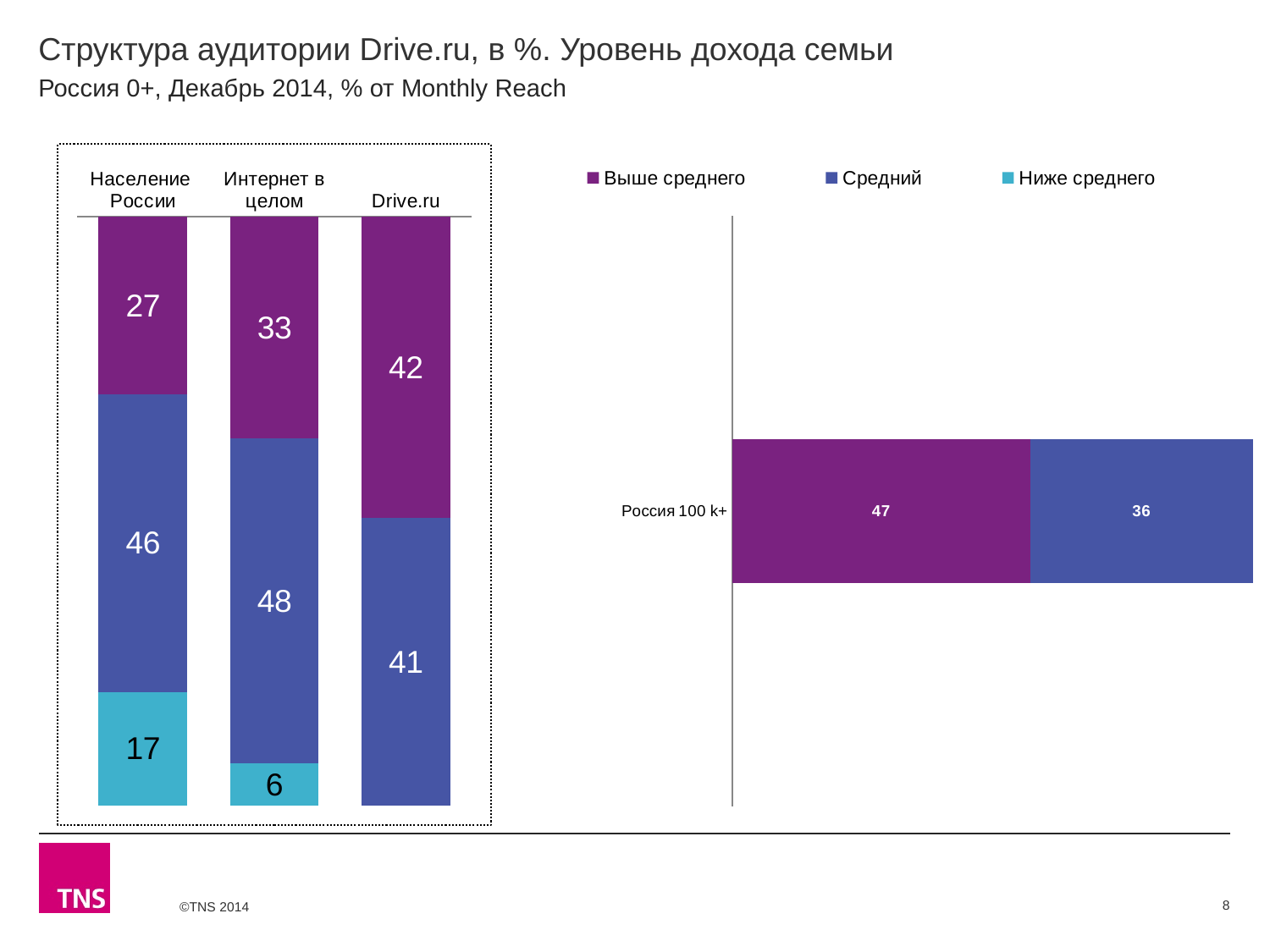
In the left chart, which category has the highest 'Выше среднего' value? Drive.ru What type of chart is the left chart? Stacked bar chart In the left chart, what is the difference between the 'Выше среднего' values for Drive.ru and 'Население России'? 15 In the left chart, which category has the lowest 'Ниже среднего' value among those with a labelled segment? Интернет в целом In the left chart, what is the value of the 'Средний' segment for 'Население России'? 46 In the right chart, what is the 'Выше среднего' value for 'Россия 100 k+'? 47 In the left chart, what is the value of the 'Выше среднего' segment for Drive.ru? 42 How many series does the legend list? 3 How many categories are shown on the x axis of the left chart? 3 In the left chart, which is larger: the 'Средний' value for 'Интернет в целом' or for Drive.ru? Интернет в целом In the right chart, what is the total of the two labelled segments for 'Россия 100 k+'? 83 In the left chart, what is the value of the 'Ниже среднего' segment for 'Интернет в целом'? 6